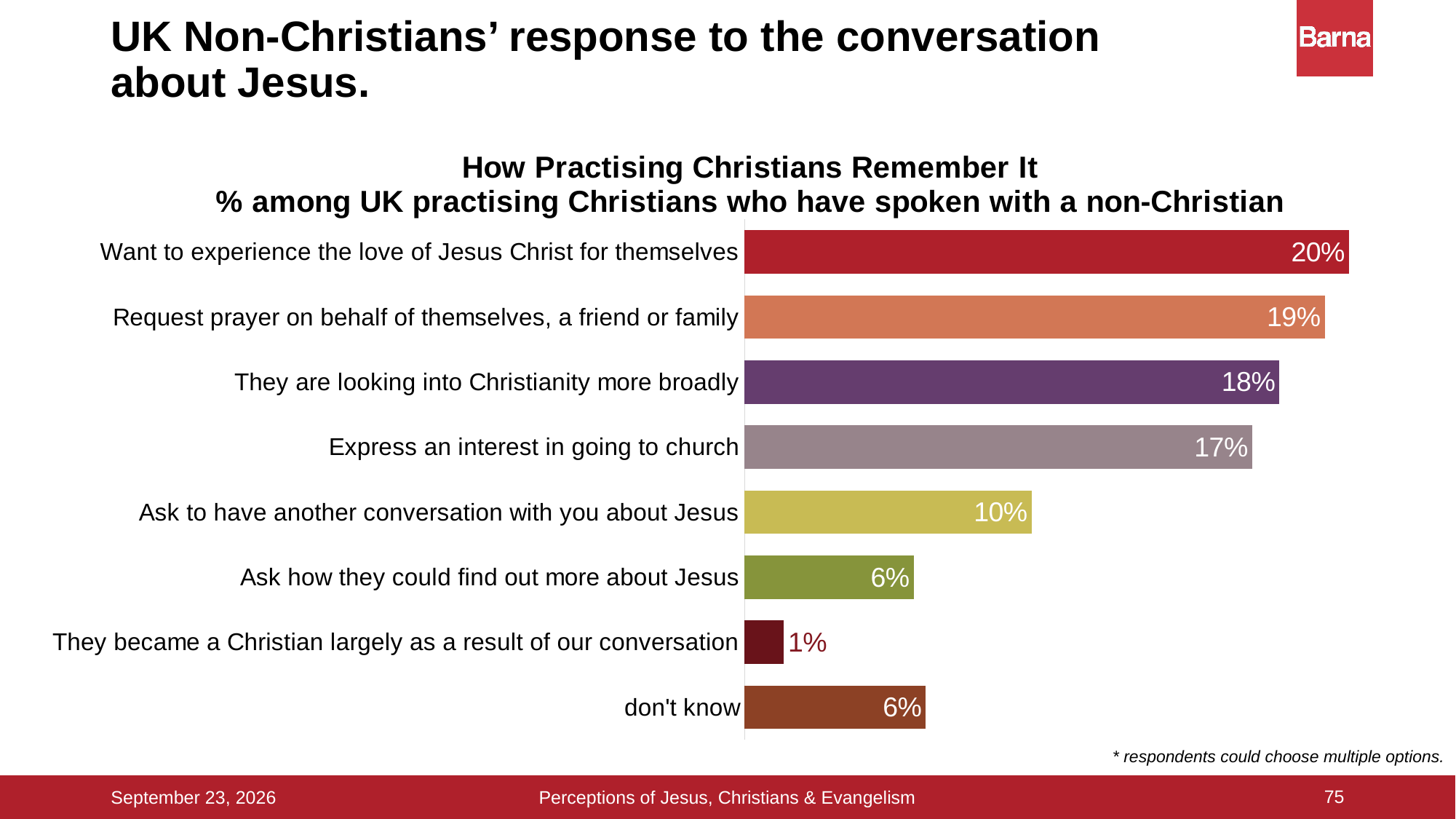
What kind of chart is shown on the slide? Bar chart How many response categories are shown in the chart? 8 Which response category has the lowest value? They became a Christian largely as a result of our conversation What percentage of UK practising Christians remember that the non-Christian wanted to experience the love of Jesus Christ for themselves? 20% What is the value for "They became a Christian largely as a result of our conversation"? 1% What is the value for "don't know"? 6% What is the value for "Request prayer on behalf of themselves, a friend or family"? 19% What is the title of the chart? How Practising Christians Remember It What is the difference between "They are looking into Christianity more broadly" and "Ask how they could find out more about Jesus"? 12% Which is larger: "Express an interest in going to church" or "Ask to have another conversation with you about Jesus"? Express an interest in going to church What is the value for "Ask to have another conversation with you about Jesus"? 10% Which response category has the highest value? Want to experience the love of Jesus Christ for themselves